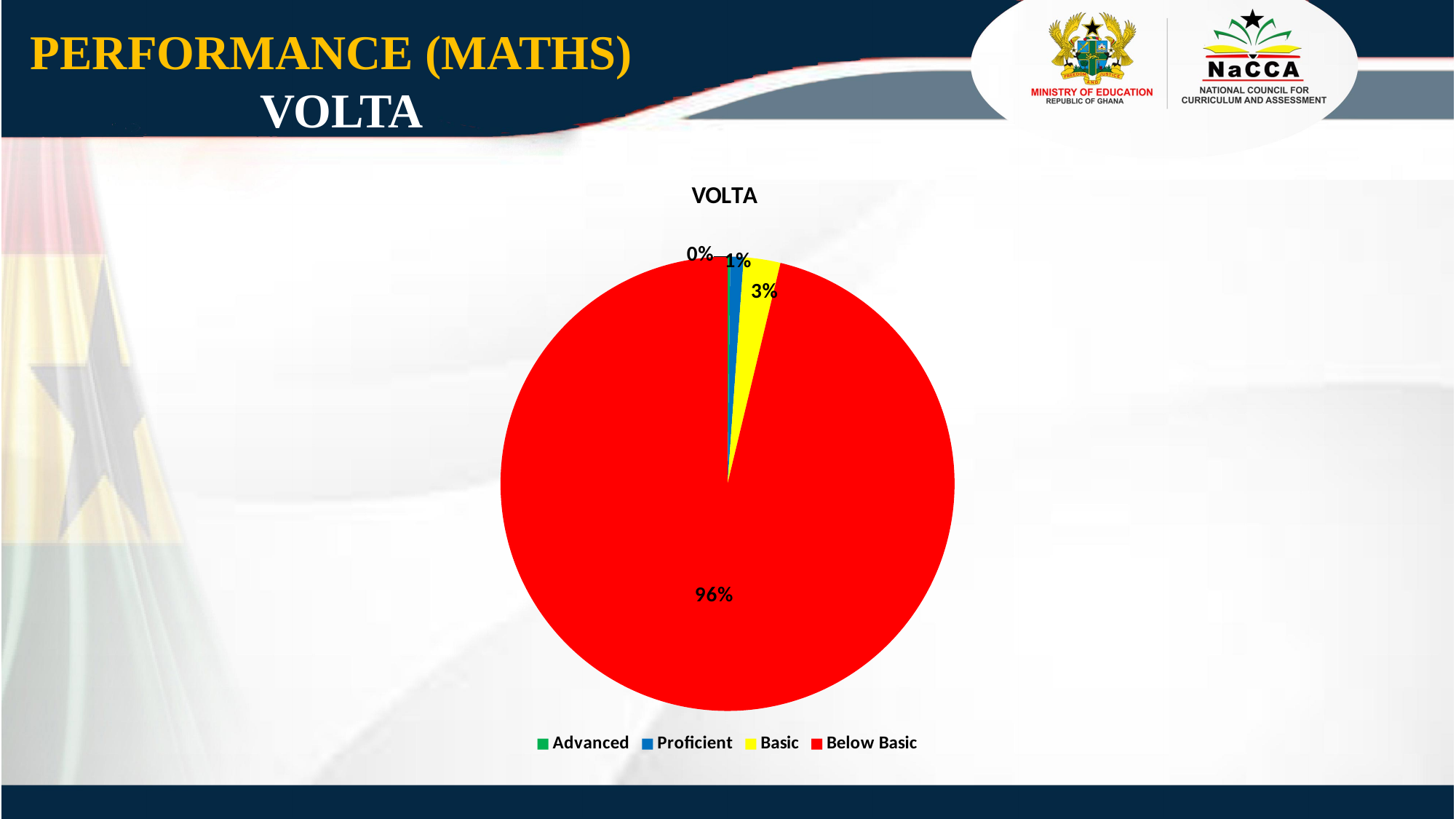
What percentage of the pie is Advanced? 0% How many categories does the legend list? 4 What percentage of the pie is Basic? 3% What kind of chart is shown on the slide? pie chart What percentage of the pie is Below Basic? 96% Which category has the smallest share of the pie? Advanced What is the chart's title? VOLTA What is the difference between the Below Basic share and the Basic share? 93% Which is larger, the Basic share or the Proficient share? Basic What colour is the Below Basic slice? red Which category has the largest share of the pie? Below Basic What percentage of the pie is Proficient? 1%